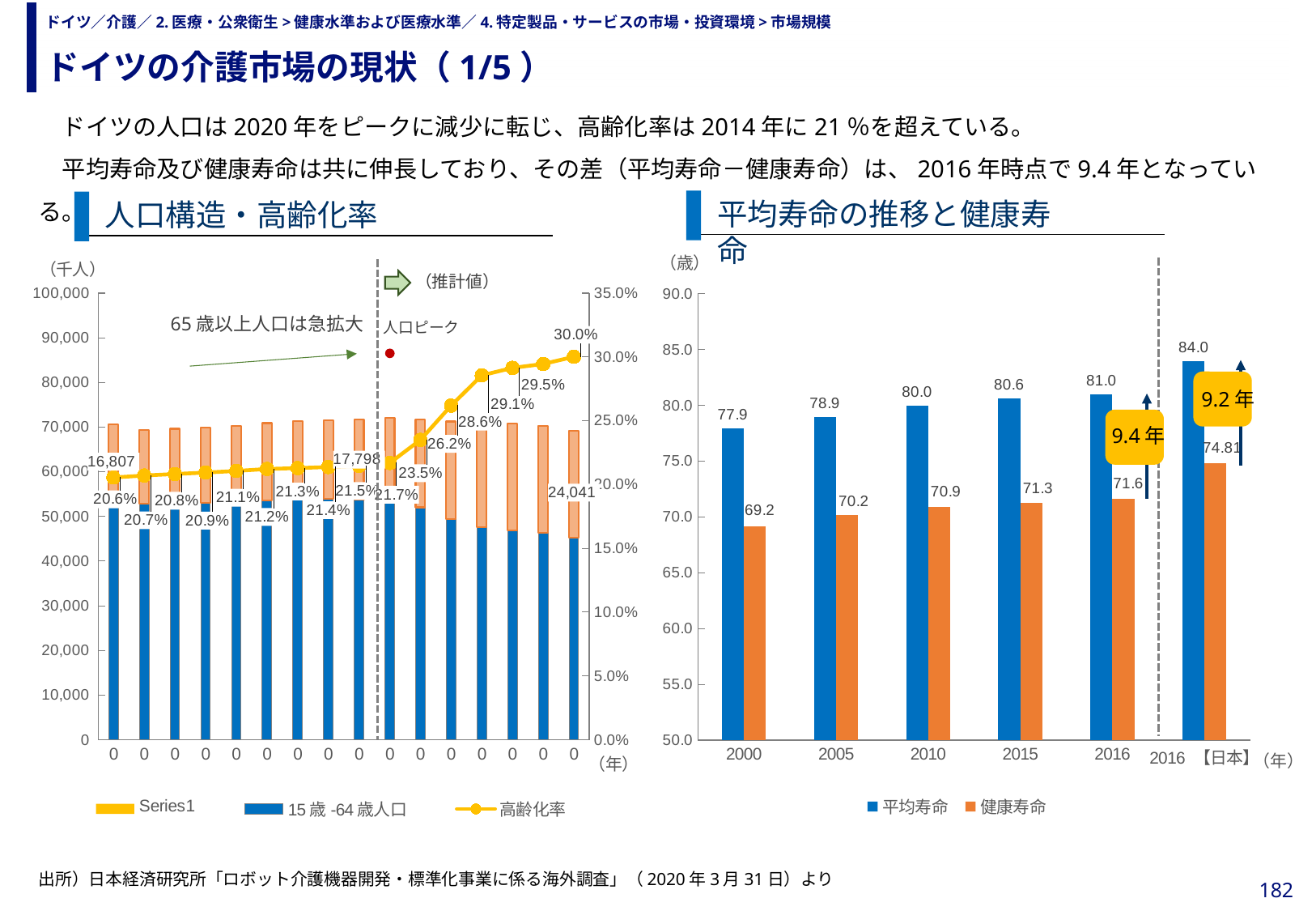
In the right chart (平均寿命の推移と健康寿命), what is the value of 平均寿命 for 2000? 77.9 In the left chart (人口構造・高齢化率), does the 高齢化率 line rise or fall from left to right? rise In the right chart (平均寿命の推移と健康寿命), which is larger: 健康寿命 for 2005 or 健康寿命 for 2015? 健康寿命 for 2015 In the right chart (平均寿命の推移と健康寿命), what is the value of 健康寿命 for 2010? 70.9 In the right chart (平均寿命の推移と健康寿命), how many series does the legend list? 2 In the right chart (平均寿命の推移と健康寿命), which category has the highest 健康寿命 value? 2016【日本】 In the right chart (平均寿命の推移と健康寿命), how many categories are shown on the x axis? 6 In the right chart (平均寿命の推移と健康寿命), what is the difference between 平均寿命 and 健康寿命 for 2016? 9.4 In the right chart (平均寿命の推移と健康寿命), what is the value of 平均寿命 for 2016【日本】? 84.0 In the right chart (平均寿命の推移と健康寿命), which category has the lowest 平均寿命 value? 2000 In the left chart (人口構造・高齢化率), how many series does the legend list? 3 In the left chart (人口構造・高齢化率), what is the highest value shown for the 高齢化率 line? 30.0%